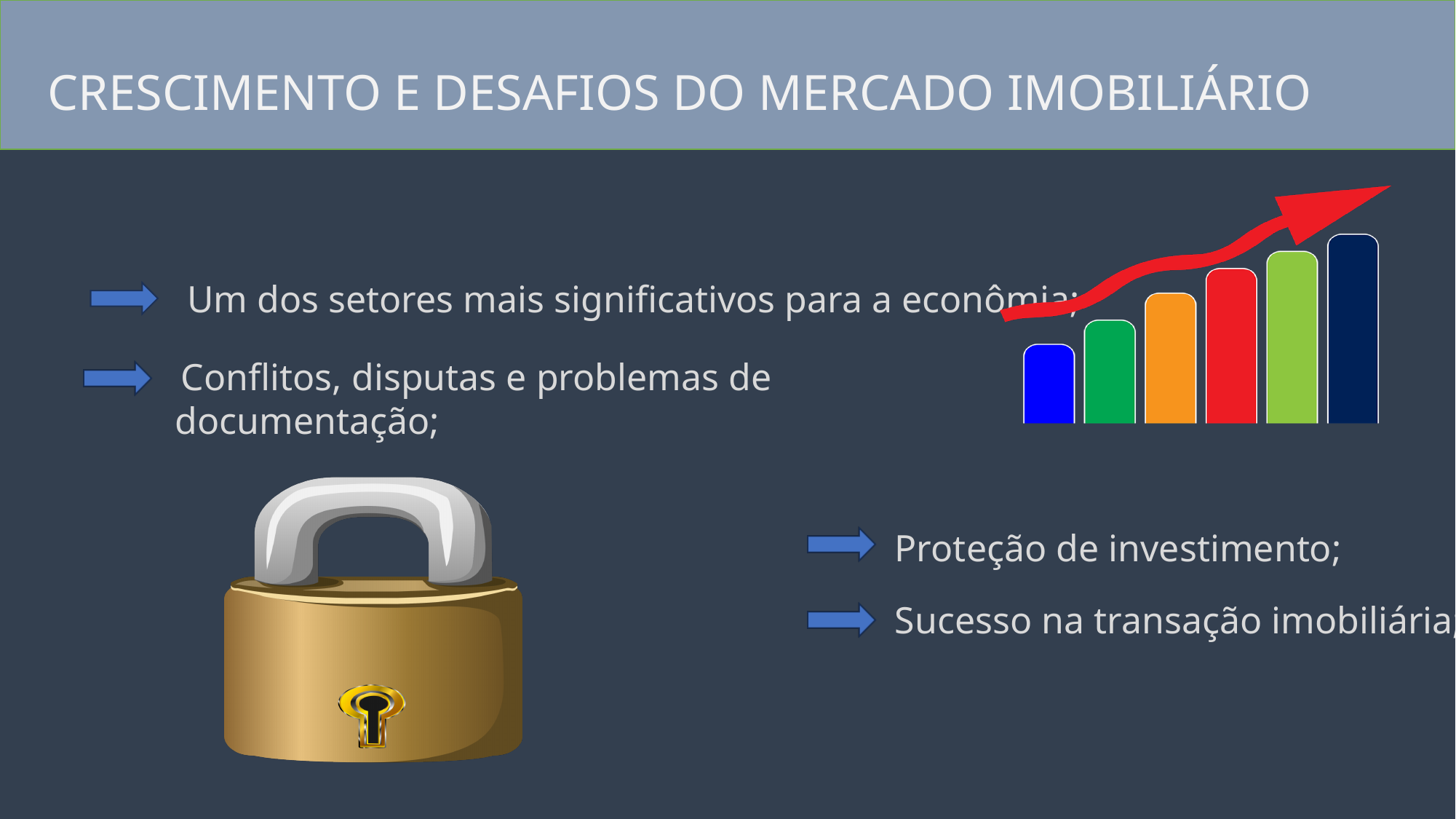
Do the bars in the chart in the upper right rise or fall from left to right? rise How many bars does the chart in the upper right of the slide show? 6 What colour is the tallest bar in the chart in the upper right of the slide? dark blue What colour is the shortest bar in the chart in the upper right of the slide? blue What kind of chart is shown in the upper right of the slide? bar chart